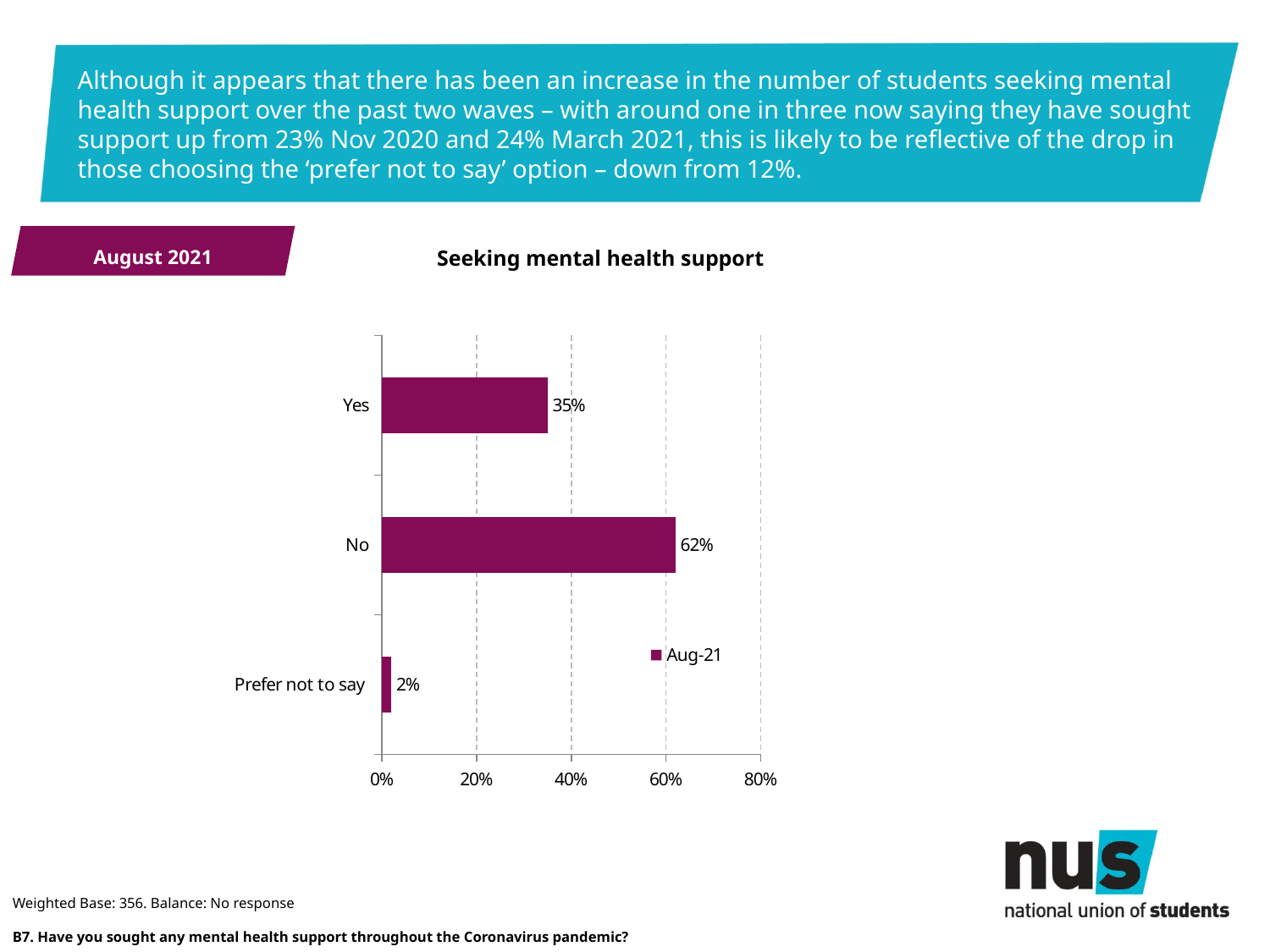
What kind of chart is shown on the slide? Bar chart Which is larger, the value for "Yes" or the value for "Prefer not to say"? Yes Which response category has the lowest value? Prefer not to say What percentage of students chose "Prefer not to say"? 2% How many series does the legend list? 1 What percentage of students answered "No" to seeking mental health support? 62% What is the difference between the "No" and "Yes" percentages? 27% What percentage of students answered "Yes" to seeking mental health support? 35% Is the value for "No" greater or less than 60%? greater How many response categories are shown in the chart? 3 What is the title of the chart? Seeking mental health support Which response category has the highest value? No